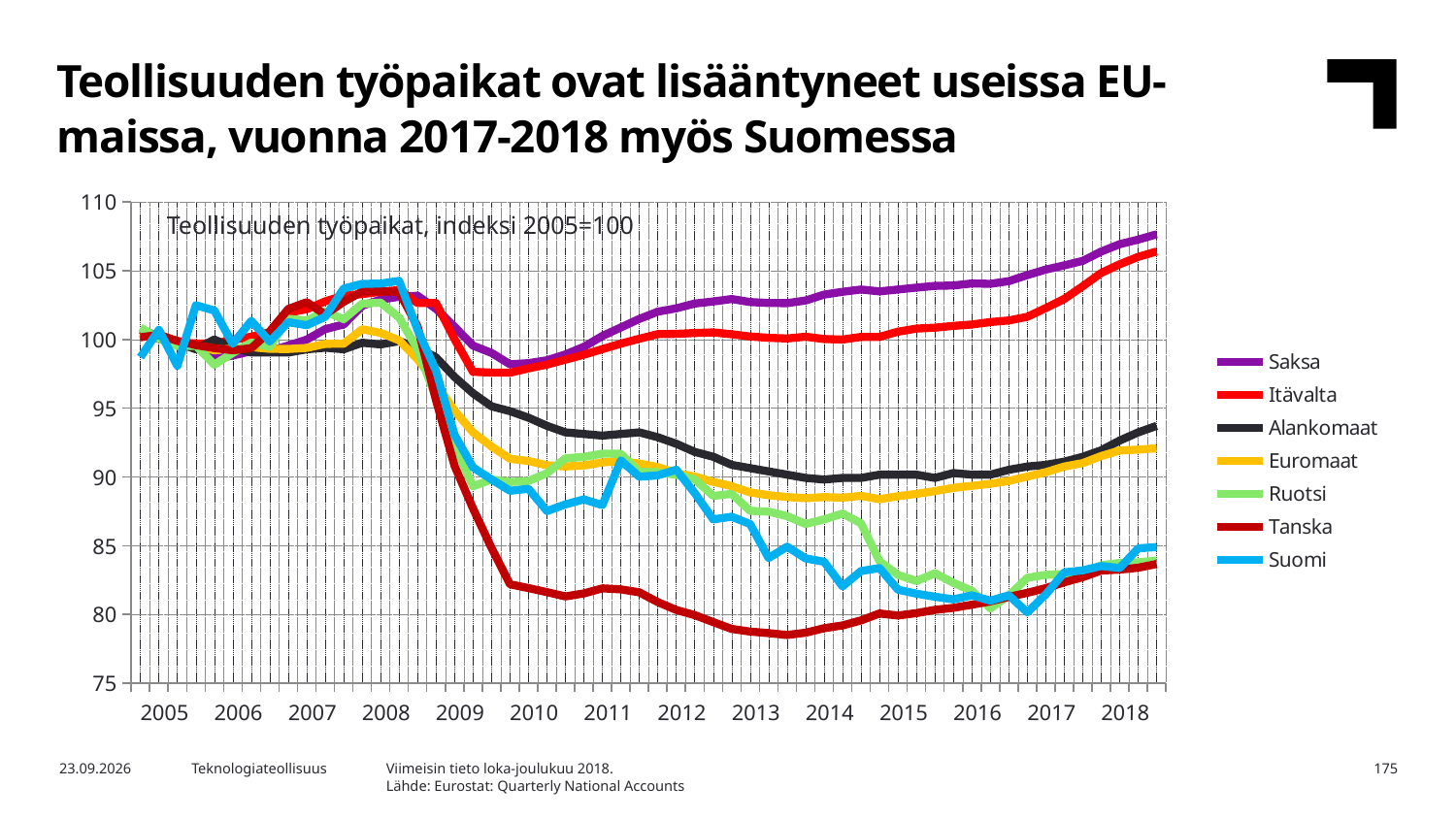
Is the value for Ruotsi in 2016 greater or less than 85? less What kind of chart is shown on the slide? line chart How many series does the legend list? 7 How many years are labelled on the x axis? 14 In 2013, which is higher: Alankomaat or Suomi? Alankomaat Is the value for Saksa at the end of 2018 greater or less than 105? greater Which series is highest at the end of 2018? Saksa Is the value for Alankomaat at the end of 2018 greater or less than 95? less Does the Saksa line rise or fall between 2014 and 2018? rise What is the title printed inside the chart area? Teollisuuden työpaikat, indeksi 2005=100 Which series reaches the lowest value anywhere on the chart? Tanska